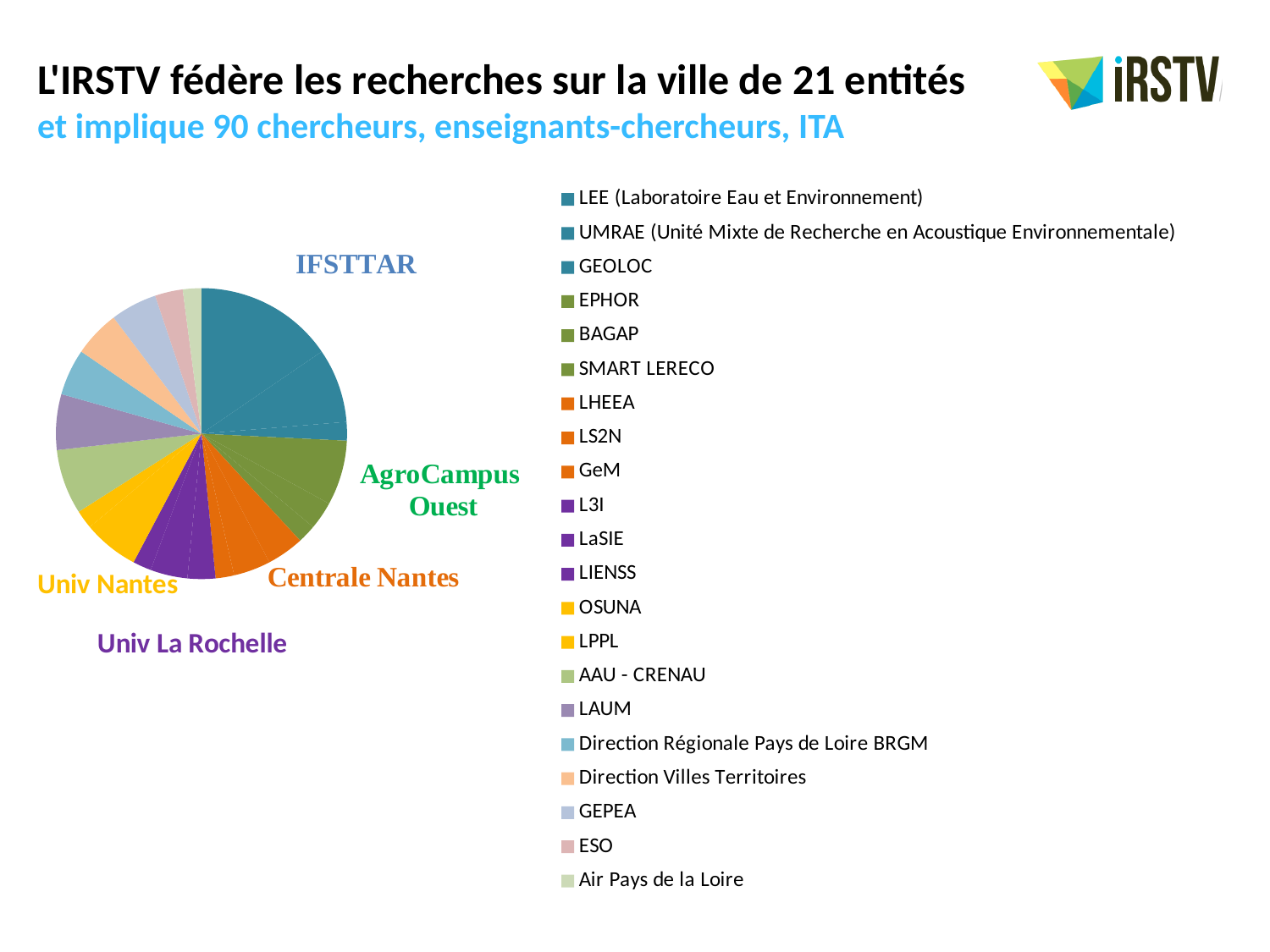
How many entries does the legend of the pie chart list? 21 Which is larger in the pie chart: the slice for LEE (Laboratoire Eau et Environnement) or the slice for ESO? LEE (Laboratoire Eau et Environnement) Which is larger in the pie chart: the slice for LEE (Laboratoire Eau et Environnement) or the slice for GEPEA? LEE (Laboratoire Eau et Environnement) Which legend entry corresponds to the largest slice of the pie chart? LEE (Laboratoire Eau et Environnement) What kind of chart is shown on the slide? pie chart According to the slide title, how many entities does the IRSTV federate? 21 How many slices does the pie chart have? 21 What is the first entry listed in the pie chart's legend? LEE (Laboratoire Eau et Environnement) What is the last entry listed in the pie chart's legend? Air Pays de la Loire